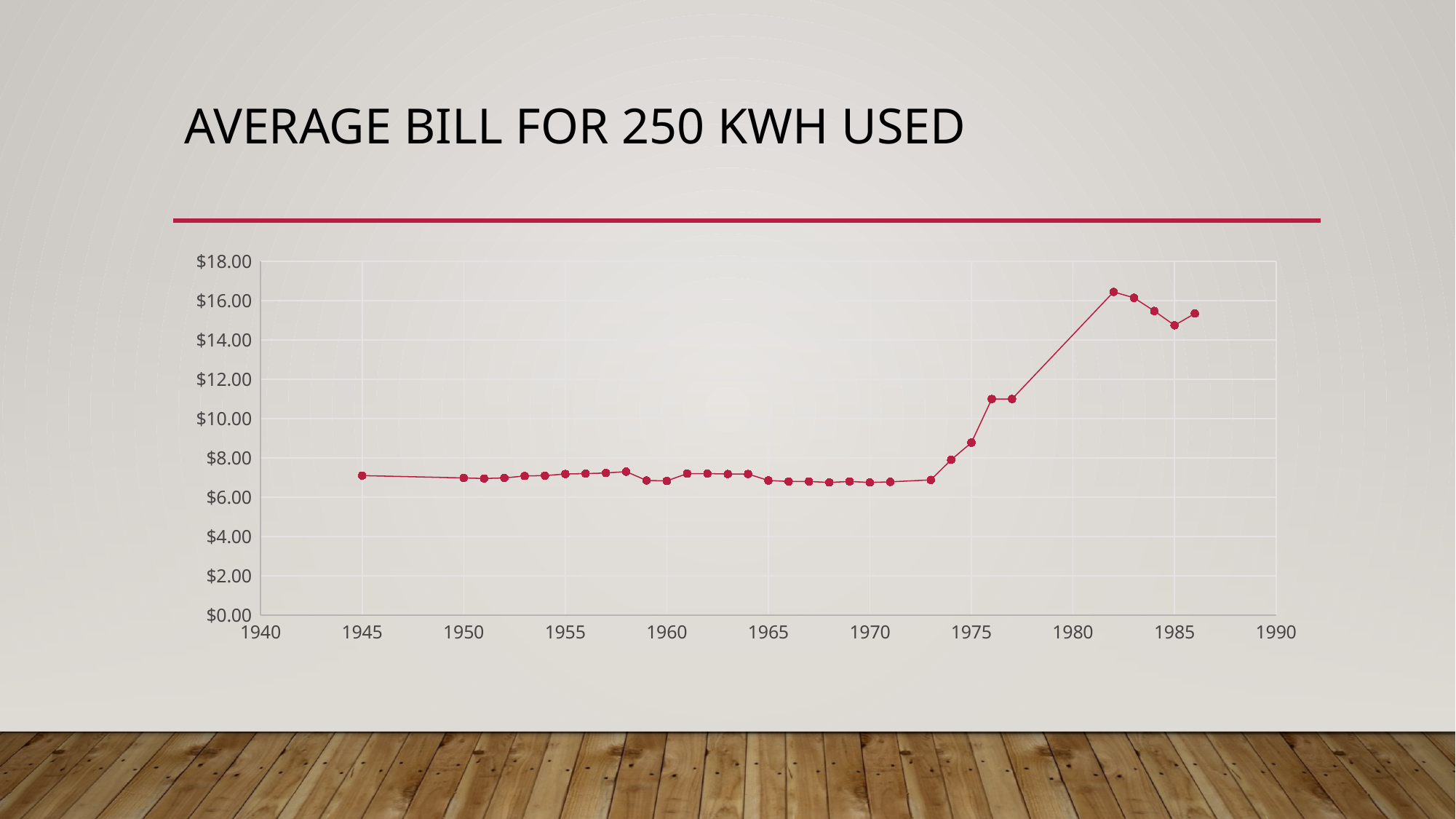
In which year is the average bill highest? 1982 What is the highest value shown on the vertical axis? $18.00 Which year has the larger average bill, 1985 or 1986? 1986 Is the value for 1976 greater or less than $10.00? greater Is the value for 1985 greater or less than $16.00? less What is the title of the chart? Average Bill for 250 kWh Used Is the value for 1975 greater or less than $8.00? greater Which year has the larger average bill, 1977 or 1982? 1982 What kind of chart is shown on the slide? line chart Does the average bill rise or fall between 1982 and 1985? fall